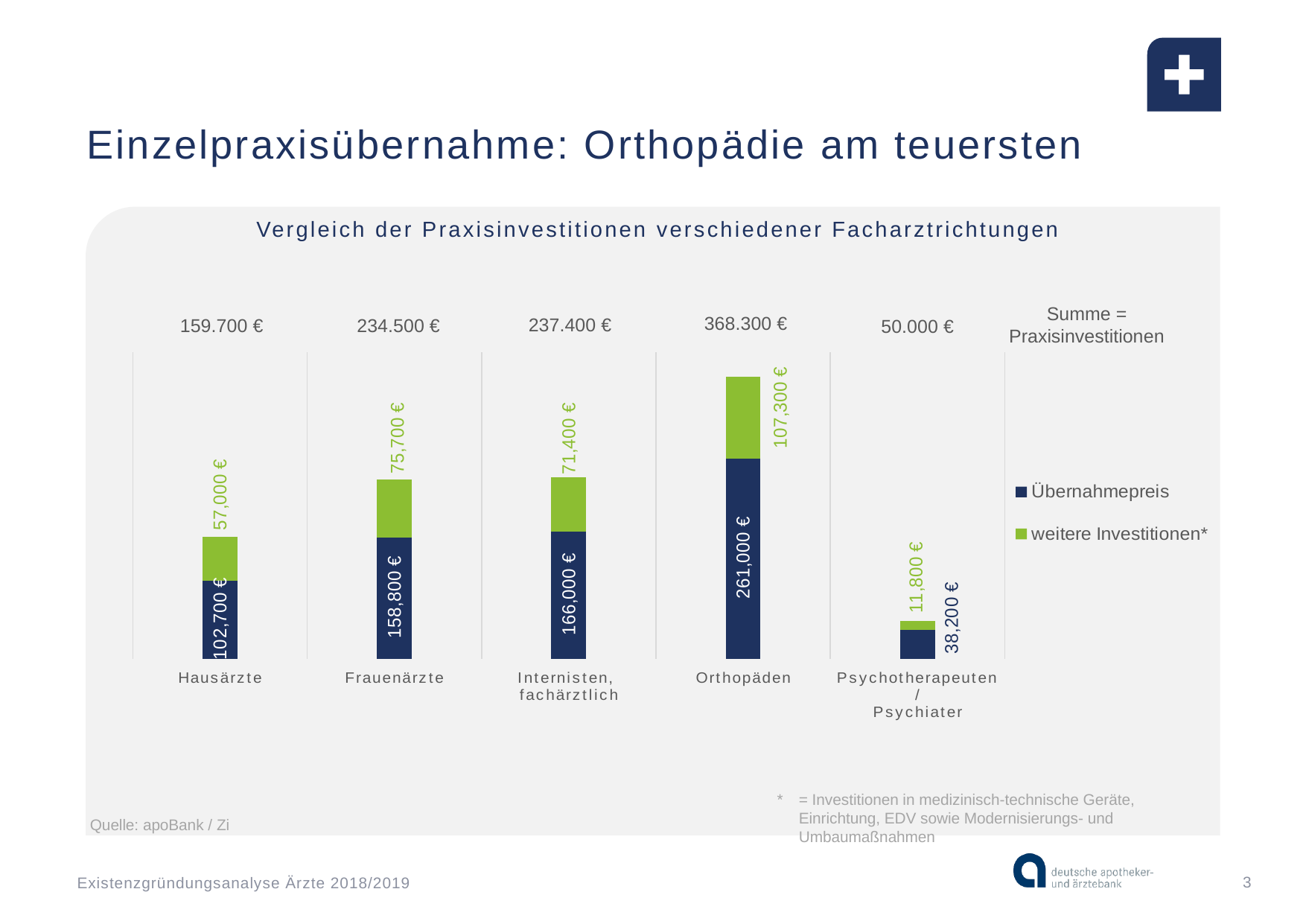
What is the total (Summe = Praxisinvestitionen) shown for Internisten, fachärztlich? 237.400 € How many specialties (categories) are shown in the chart? 5 What is the Übernahmepreis for Orthopäden? 261,000 € What kind of chart is shown on the slide? Stacked bar chart What is the value of weitere Investitionen for Frauenärzte? 75,700 € What is the Übernahmepreis for Psychotherapeuten / Psychiater? 38,200 € What is the title of the chart? Vergleich der Praxisinvestitionen verschiedener Facharztrichtungen Which is larger: the weitere Investitionen for Hausärzte or for Internisten, fachärztlich? Internisten, fachärztlich What is the difference between the Übernahmepreis for Internisten, fachärztlich and for Frauenärzte? 7,200 € Which specialty has the lowest Übernahmepreis? Psychotherapeuten / Psychiater How many series does the legend list? 2 Which specialty has the highest total Praxisinvestitionen? Orthopäden